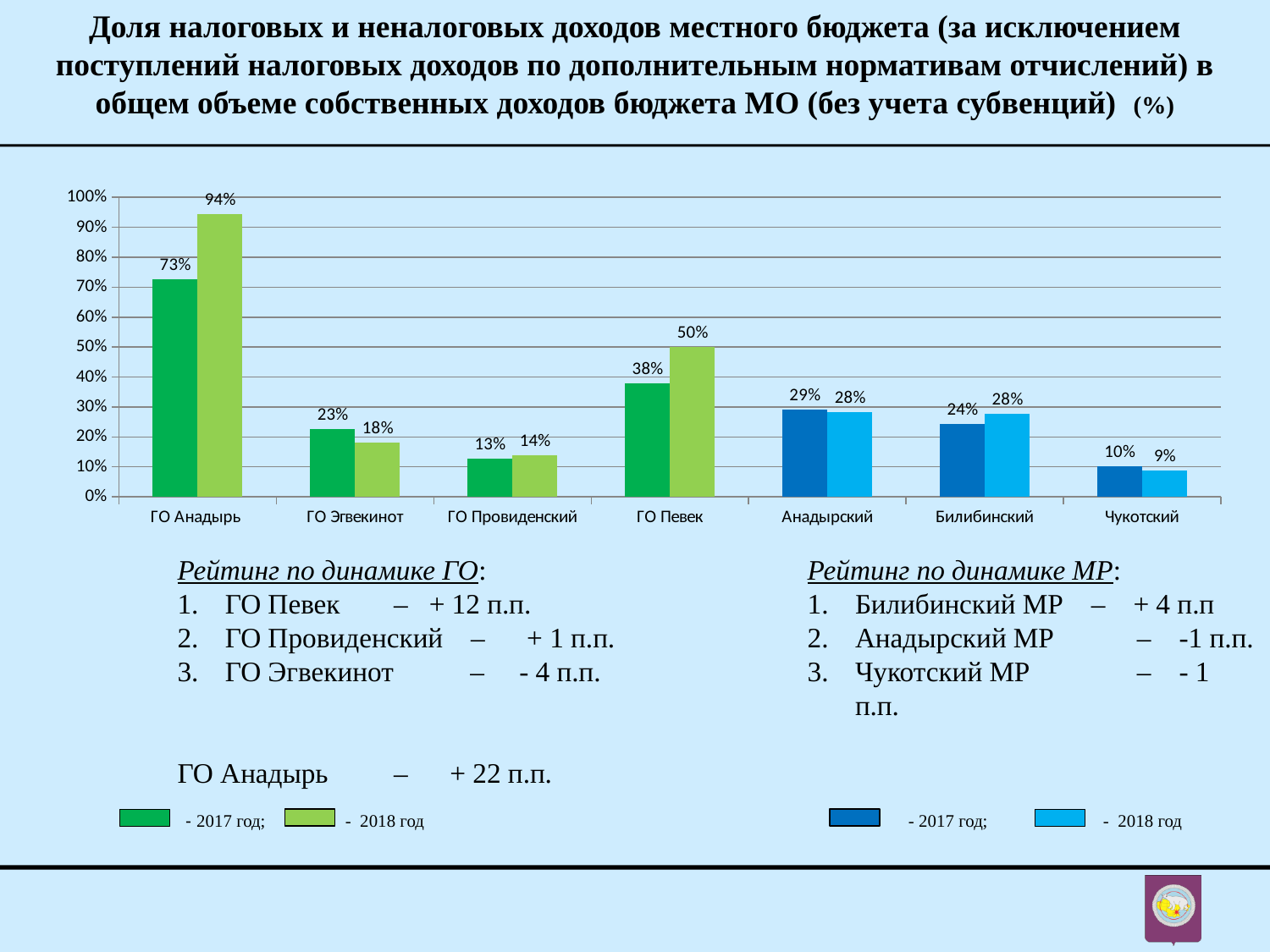
What is the 2018 value for Чукотский? 9% What is the difference between the 2018 and 2017 values for ГО Певек? 12 percentage points Which category has the lowest 2017 value? Чукотский What is the 2017 value for ГО Певек? 38% What is the 2018 value for ГО Анадырь? 94% What is the 2017 value for Билибинский? 24% How many categories are shown on the x axis? 7 Which two years does the legend compare? 2017 and 2018 Which is larger for ГО Эгвекинот: the 2017 value or the 2018 value? 2017 What type of chart is shown on the slide? Bar chart What is the difference between the 2018 and 2017 values for ГО Анадырь? 21 percentage points Which category has the highest 2018 value? ГО Анадырь